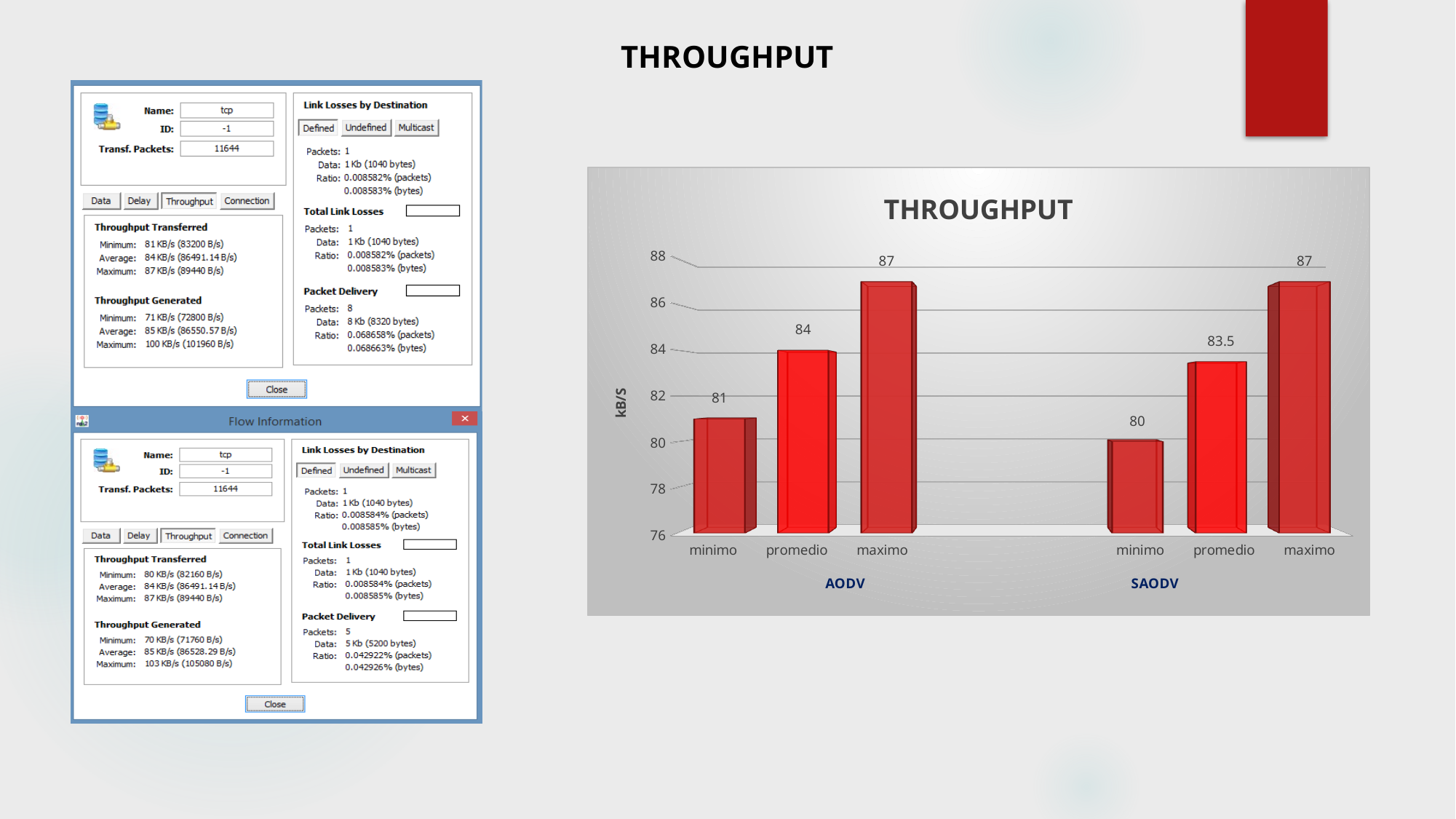
Which bar has the lowest value in the THROUGHPUT chart? SAODV minimo Which is larger in the THROUGHPUT chart: the 'minimo' value for AODV or the 'minimo' value for SAODV? AODV minimo What kind of chart is the THROUGHPUT chart? Bar chart What is the difference between the 'maximo' and 'minimo' values for SAODV in the THROUGHPUT chart? 7 What is the value of the 'maximo' bar for AODV in the THROUGHPUT chart? 87 What is the label of the vertical axis in the THROUGHPUT chart? kB/S What is the value of the 'promedio' bar for SAODV in the THROUGHPUT chart? 83.5 What is the value of the 'minimo' bar for SAODV in the THROUGHPUT chart? 80 How many bars are plotted in the THROUGHPUT chart? 6 What is the difference between the 'promedio' values for AODV and SAODV in the THROUGHPUT chart? 0.5 Do the values rise or fall from 'minimo' to 'maximo' within the AODV group in the THROUGHPUT chart? Rise What is the value of the 'minimo' bar for AODV in the THROUGHPUT chart? 81